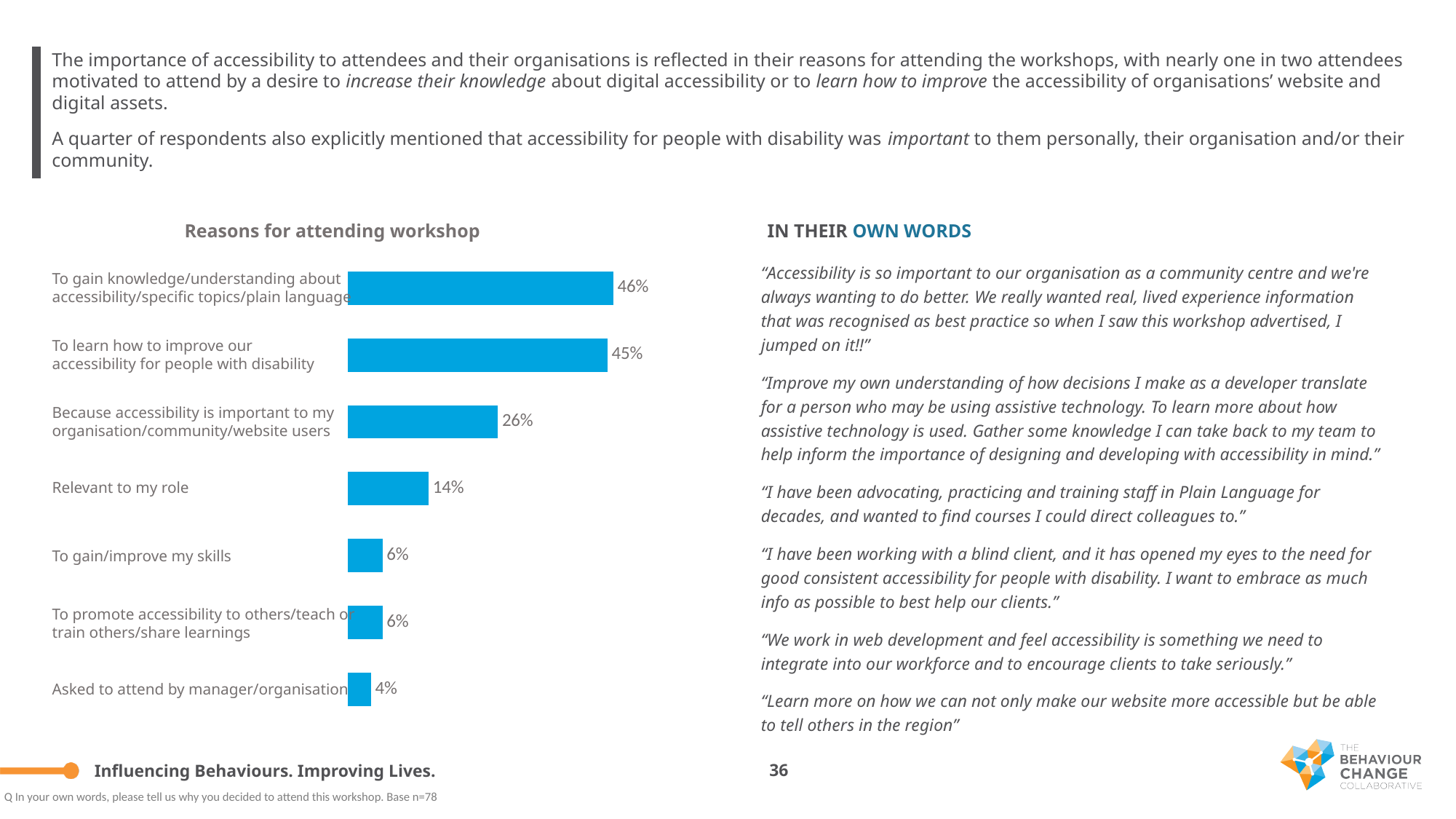
Which is larger: the value for 'Relevant to my role' or the value for 'To gain/improve my skills'? Relevant to my role What is the title of the chart on the slide? Reasons for attending workshop What percentage of respondents said 'Because accessibility is important to my organisation/community/website users'? 26% What colour are the bars in the Reasons for attending workshop chart? Blue What kind of chart is the Reasons for attending workshop chart? Bar chart What is the difference between 'To gain knowledge/understanding about accessibility/specific topics/plain language' and 'To learn how to improve our accessibility for people with disability'? 1% Which reason for attending the workshop has the lowest value? Asked to attend by manager/organisation What is the difference between 'Because accessibility is important to my organisation/community/website users' and 'Relevant to my role'? 12% How many reasons (categories) are shown in the Reasons for attending workshop chart? 7 Which reason for attending the workshop has the highest value? To gain knowledge/understanding about accessibility/specific topics/plain language What is the value for 'Asked to attend by manager/organisation'? 4% What is the value for 'Relevant to my role' in the Reasons for attending workshop chart? 14%